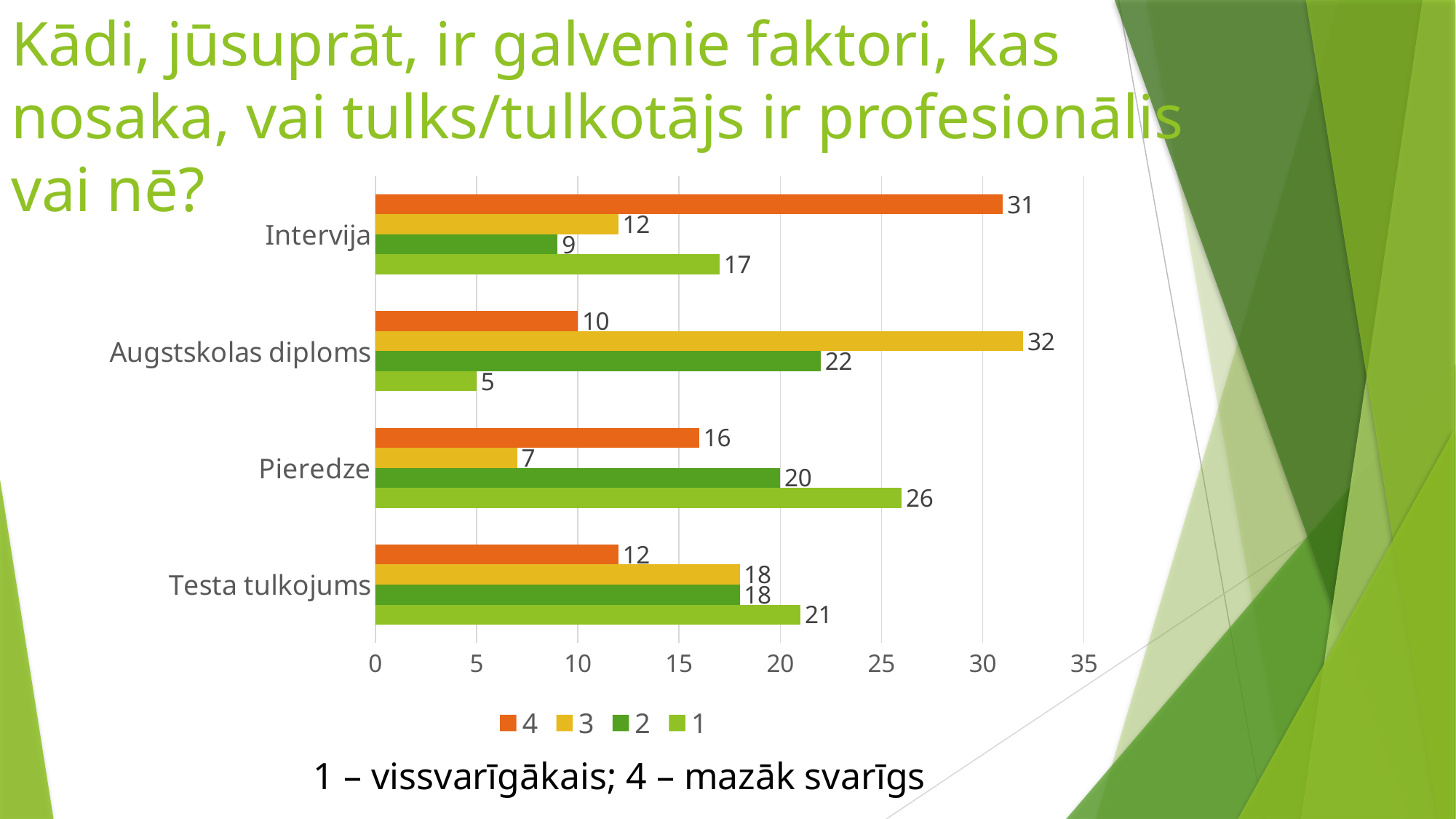
What is the value of series 1 for Pieredze? 26 Which category has the lowest value for series 3? Pieredze Which is larger for Intervija: the value of series 1 or the value of series 2? series 1 Which category has the highest value for series 1? Pieredze What is the value of series 3 for Augstskolas diploms? 32 How many series does the legend list? 4 What is the difference between the series 3 value and the series 4 value for Augstskolas diploms? 22 What kind of chart is shown on the slide? bar chart According to the note below the legend, which rating means the most important? 1 What is the value of series 4 for Intervija? 31 What is the value of series 2 for Testa tulkojums? 18 How many categories are shown on the chart? 4